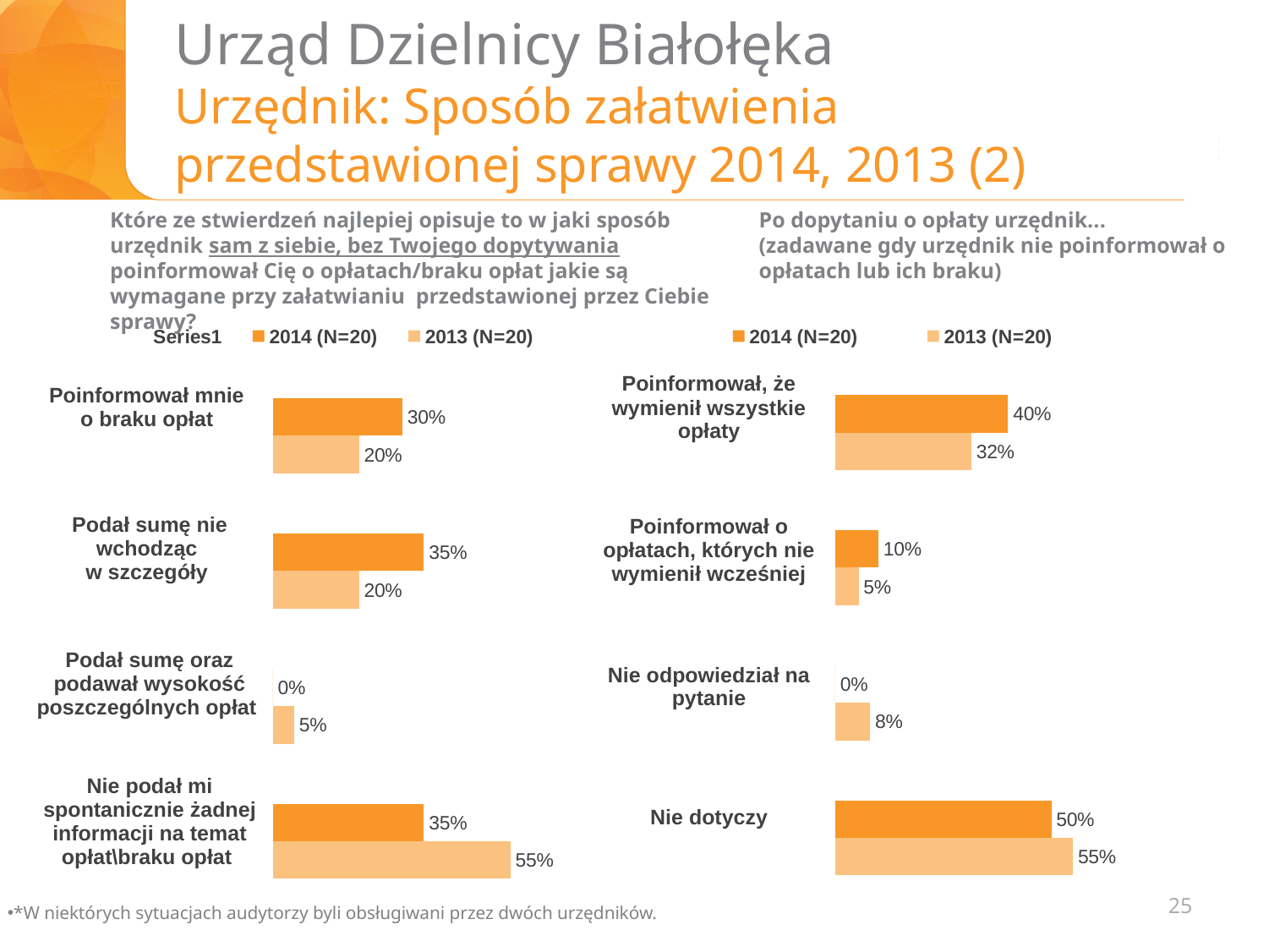
In the right chart, what is the difference between the 2014 and 2013 values for "Poinformował, że wymienił wszystkie opłaty"? 8% How many series does the legend of the right chart list? 2 In the right chart, what is the 2013 value for "Nie odpowiedział na pytanie"? 8% In the left chart, what is the 2014 value for "Poinformował mnie o braku opłat"? 30% In the right chart, which is larger for "Nie dotyczy": the 2014 value or the 2013 value? 2013 In the left chart, what is the difference between the 2013 and 2014 values for "Nie podał mi spontanicznie żadnej informacji na temat opłat\braku opłat"? 20% In the left chart, which category has the highest 2013 value? Nie podał mi spontanicznie żadnej informacji na temat opłat\braku opłat How many categories does the left chart show? 4 In the left chart, what is the 2013 value for "Nie podał mi spontanicznie żadnej informacji na temat opłat\braku opłat"? 55% In the right chart, which category has the lowest 2014 value? Nie odpowiedział na pytanie In the right chart, what is the 2014 value for "Poinformował, że wymienił wszystkie opłaty"? 40% What type of chart is the left chart? Bar chart